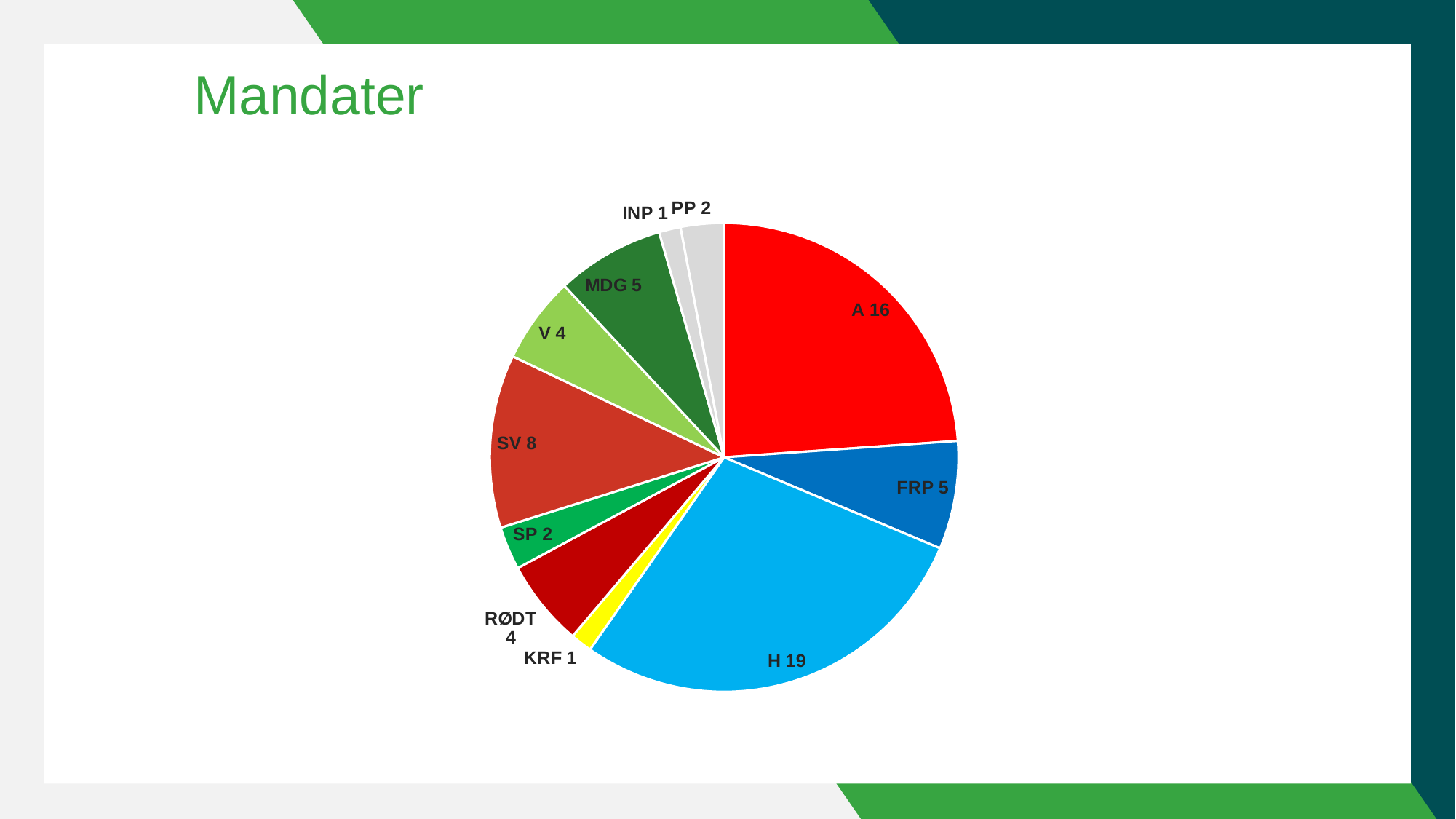
What is the title of the slide? Mandater Which party has the largest slice in the pie chart? H What is the value for RØDT in the pie chart? 4 What is the value for SV in the pie chart? 8 How many slices does the pie chart have? 11 What is the total of all the values shown in the pie chart? 67 What is the value for MDG in the pie chart? 5 What kind of chart is shown on the slide? pie chart What is the value for H in the pie chart? 19 What is the difference between the values for H and A? 3 Which is larger, the value for FRP or the value for V? FRP What is the difference between the values for SV and SP? 6